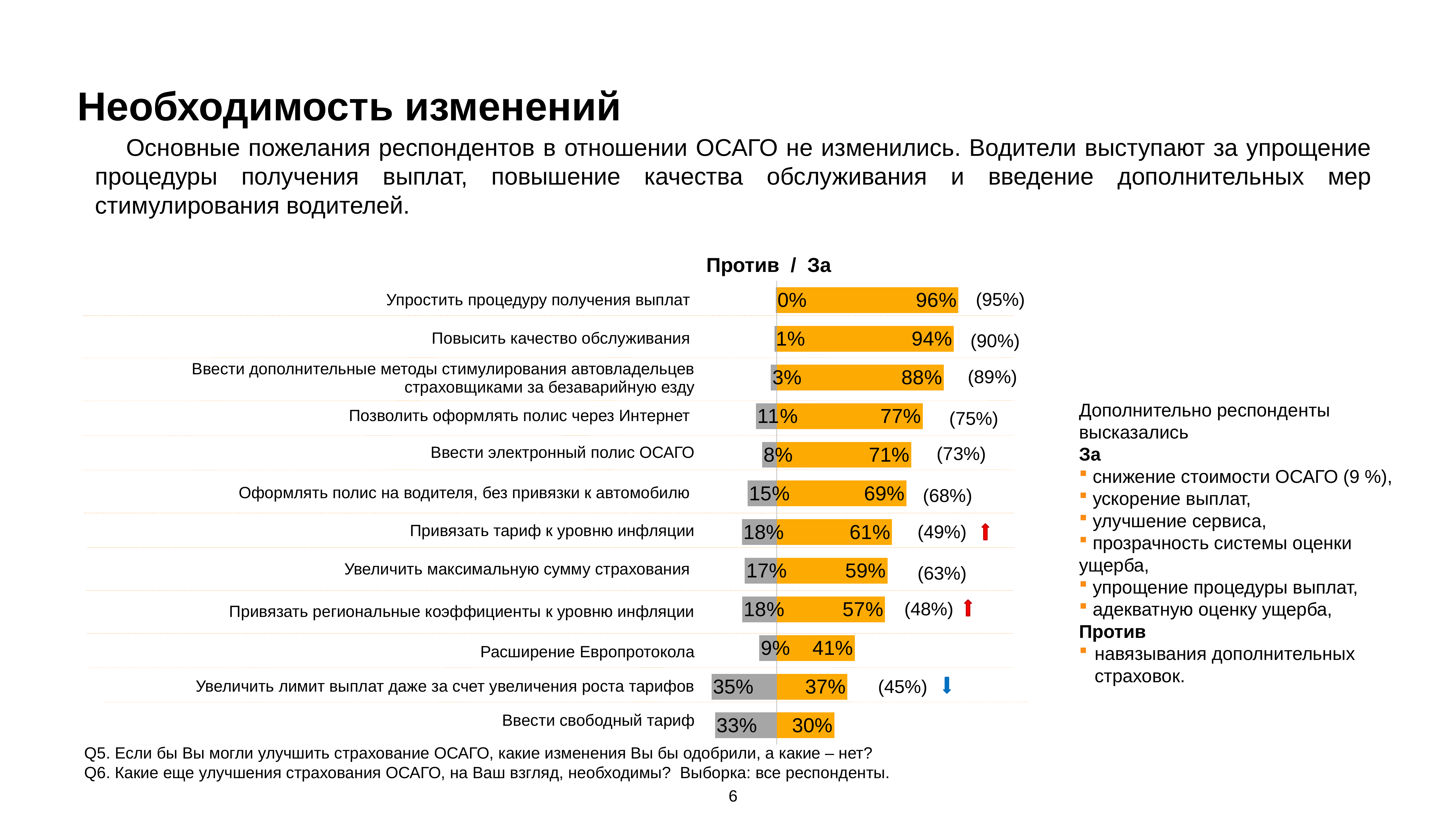
What is the "Против" value for "Увеличить лимит выплат даже за счет увеличения роста тарифов"? 35% What is the "Против" value for "Позволить оформлять полис через Интернет"? 11% Which category has the highest "Против" value? Увеличить лимит выплат даже за счет увеличения роста тарифов Which category has the highest "За" value? Упростить процедуру получения выплат What is the "За" value for "Расширение Европротокола"? 41% What is the difference between the "За" and "Против" values for "Ввести свободный тариф"? 3% What type of chart is shown on the slide? Bar chart What colour are the "За" bars in the chart? Orange What is the "За" value for "Упростить процедуру получения выплат"? 96% How many categories are shown in the chart? 12 Which is larger: the "За" value for "Ввести электронный полис ОСАГО" or the "За" value for "Оформлять полис на водителя, без привязки к автомобилю"? Ввести электронный полис ОСАГО Which category has the lowest "За" value? Ввести свободный тариф